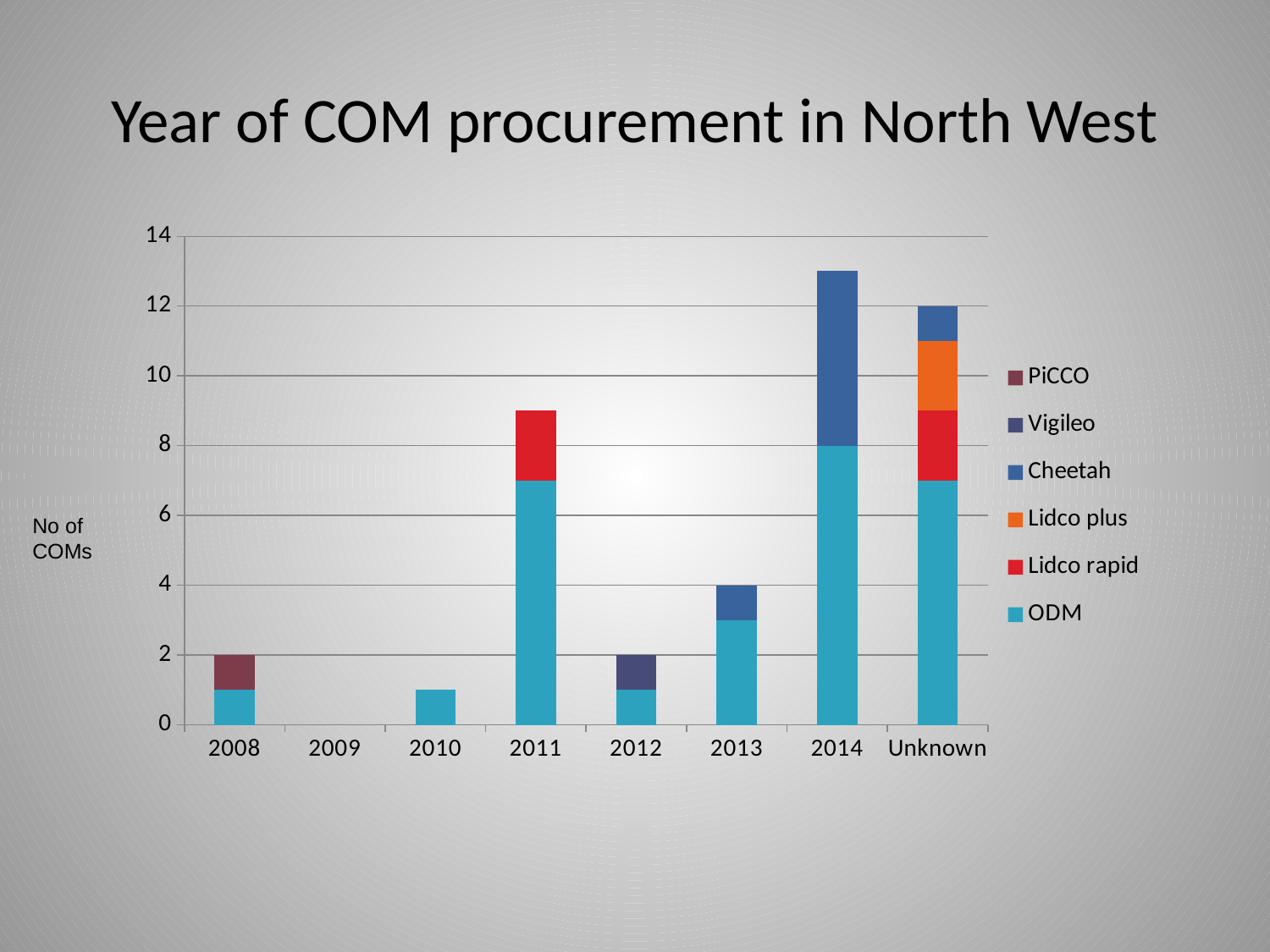
What is the total number of COMs for the Unknown category? 12 How many categories are shown on the x axis? 8 What kind of chart is shown on the slide? Stacked bar chart Which year has no COMs procured at all? 2009 Which year has the highest total number of COMs? 2014 What is the difference between the total for Unknown and the total for 2013? 8 Is the total for 2011 greater or less than 10? less What is the total number of COMs for 2013? 4 What is the total number of COMs for 2008? 2 Is the total for 2014 greater or less than 12? greater What is the ODM value for 2014? 8 How many series does the legend list? 6